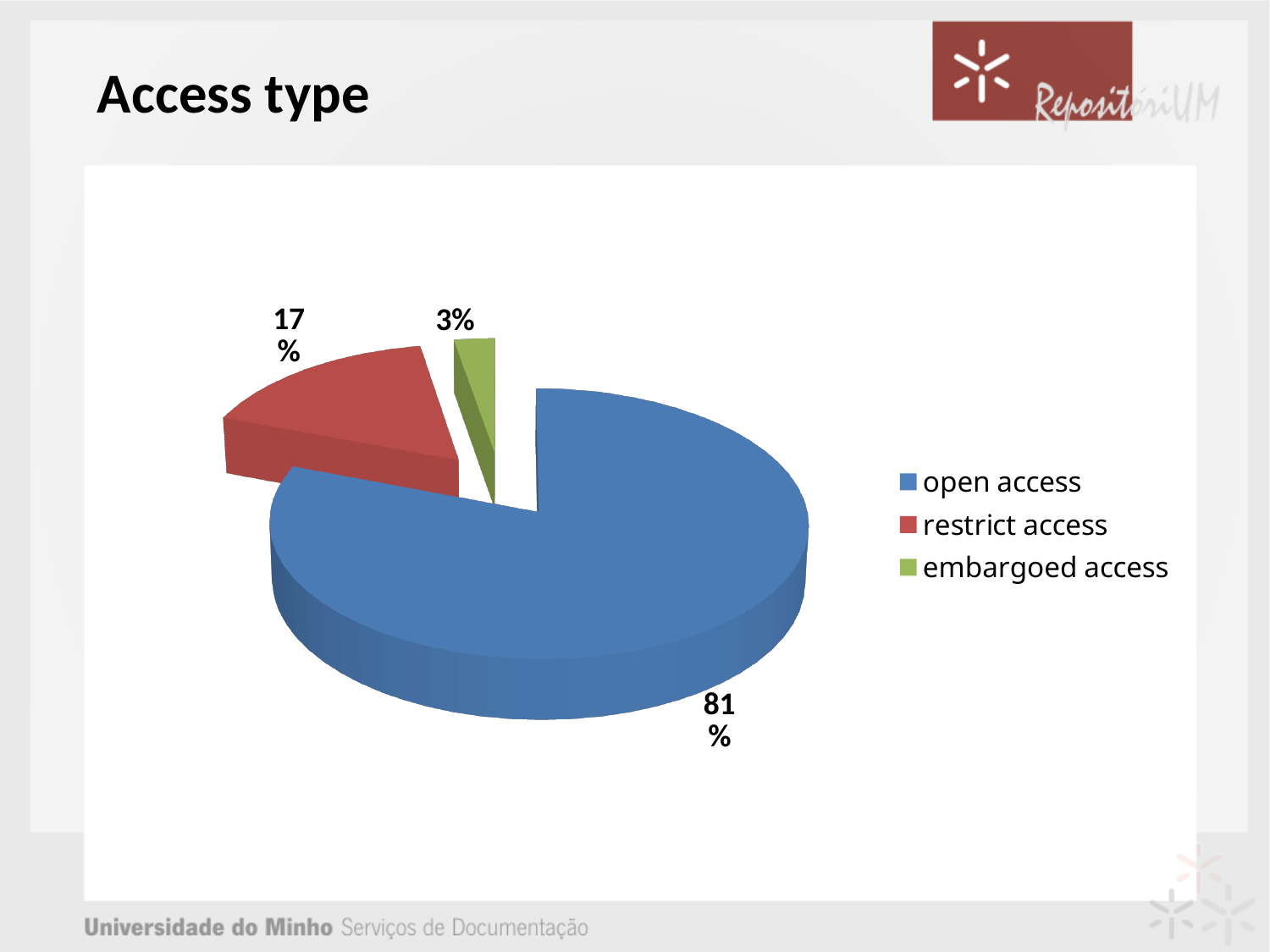
What is the difference in percentage points between open access and restrict access? 64 How many slices does the pie chart have? 3 What share of the pie is embargoed access? 3% Which access type has the largest share of the pie? open access Which colour represents restrict access in the legend? red What is the difference in percentage points between restrict access and embargoed access? 14 Which access type has the smallest share of the pie? embargoed access Which is larger, the share for restrict access or the share for embargoed access? restrict access What is the title of the slide containing the chart? Access type What share of the pie is restrict access? 17% What kind of chart is shown on the slide? pie chart What share of the pie is open access? 81%